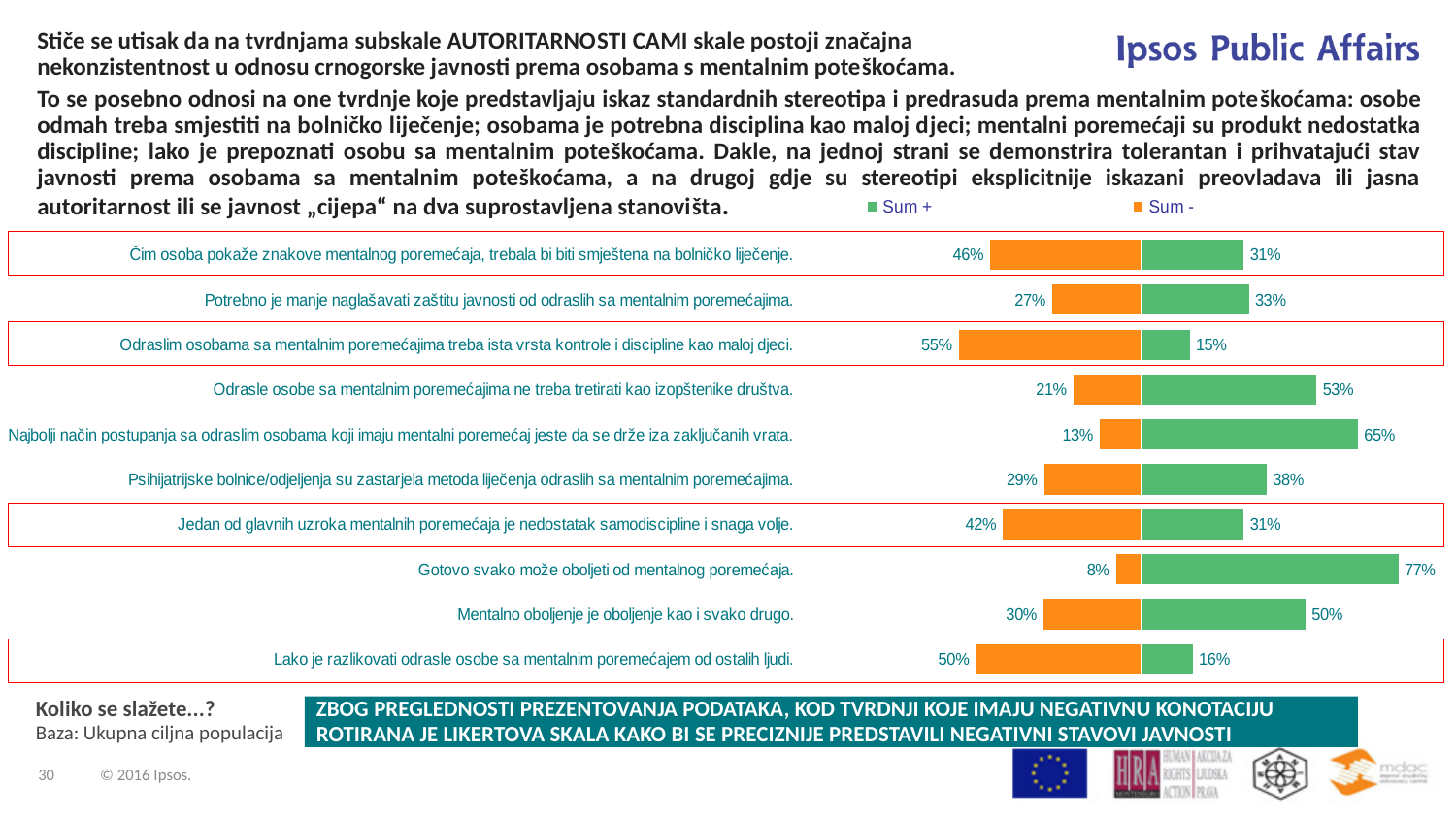
What is the difference between the Sum - and Sum + values for "Najbolji način postupanja sa odraslim osobama koji imaju mentalni poremećaj jeste da se drže iza zaključanih vrata."? 52% What is the Sum + value for "Gotovo svako može oboljeti od mentalnog poremećaja."? 77% Which statement has the highest Sum + value? Gotovo svako može oboljeti od mentalnog poremećaja. What is the Sum - value for "Odraslim osobama sa mentalnim poremećajima treba ista vrsta kontrole i discipline kao maloj djeci."? 55% Which statement has the lowest Sum + value? Odraslim osobama sa mentalnim poremećajima treba ista vrsta kontrole i discipline kao maloj djeci. What is the Sum + value for "Lako je razlikovati odrasle osobe sa mentalnim poremećajem od ostalih ljudi."? 16% Which statement has the highest Sum - value? Odraslim osobama sa mentalnim poremećajima treba ista vrsta kontrole i discipline kao maloj djeci. What type of chart is shown on the slide? bar chart For "Mentalno oboljenje je oboljenje kao i svako drugo.", which is larger, Sum + or Sum -? Sum + How many statements (categories) are plotted in the chart? 10 How many series does the legend list? 2 Which colour represents the Sum + series in the chart? green